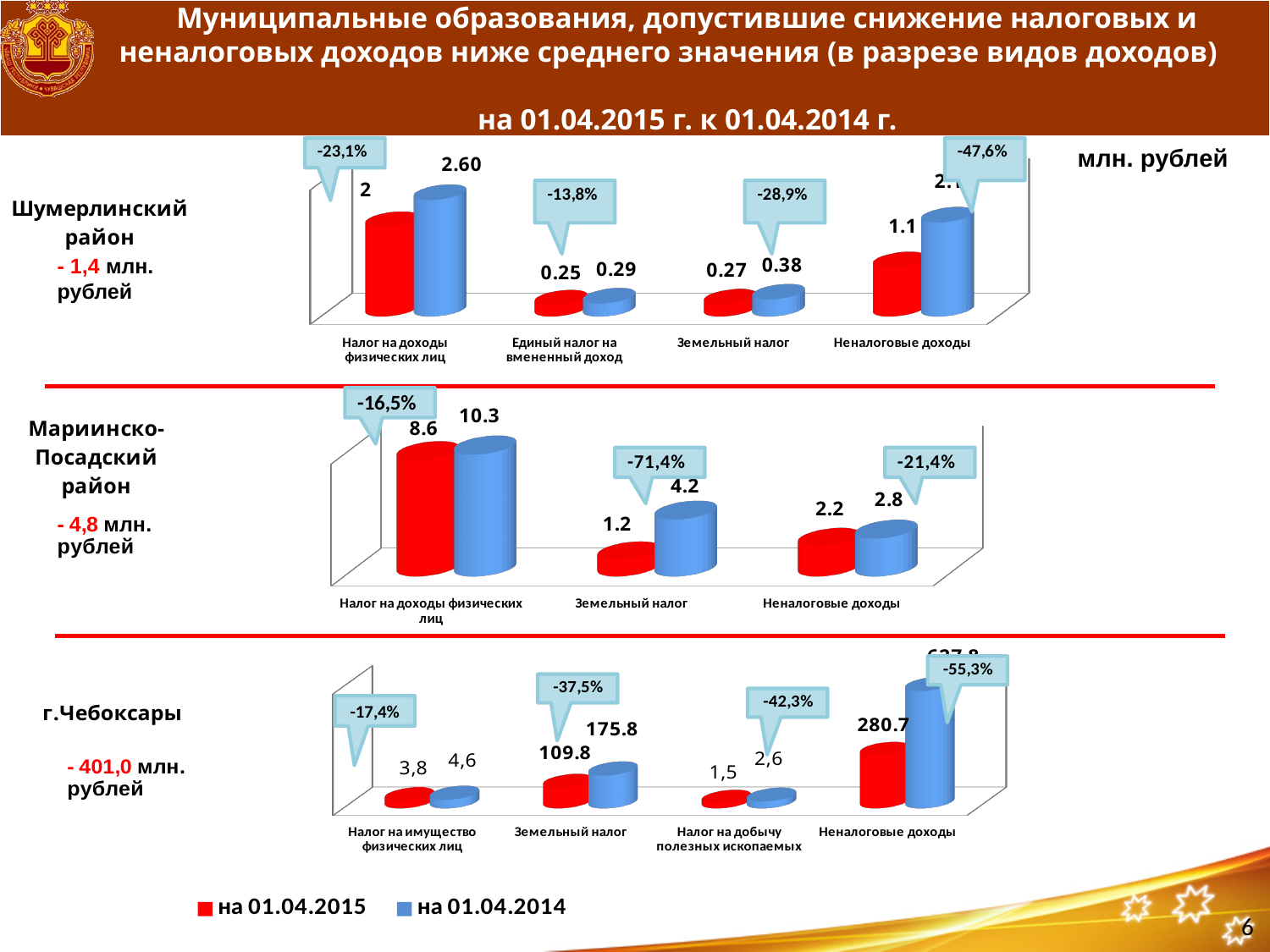
In the г.Чебоксары chart, which is larger for Налог на добычу полезных ископаемых: the на 01.04.2015 value or the на 01.04.2014 value? на 01.04.2014 In the Мариинско-Посадский район chart, what percentage change is shown in the callout above Земельный налог? -71,4% In the Шумерлинский район chart, what is the value for Налог на доходы физических лиц for на 01.04.2014? 2.60 In the Мариинско-Посадский район chart, which category has the highest value for на 01.04.2015? Налог на доходы физических лиц How many series does the legend at the bottom of the slide list? 2 In the Мариинско-Посадский район chart, what is the difference between the на 01.04.2014 and на 01.04.2015 values for Налог на доходы физических лиц? 1.7 In the г.Чебоксары chart, what is the value for Земельный налог for на 01.04.2015? 109.8 In the Шумерлинский район chart, which category has the lowest value for на 01.04.2015? Единый налог на вмененный доход In the Мариинско-Посадский район chart, what is the value for Земельный налог for на 01.04.2014? 4.2 In the г.Чебоксары chart, what is the difference between the на 01.04.2014 and на 01.04.2015 values for Земельный налог? 66.0 In the Шумерлинский район chart, what is the value for Земельный налог for на 01.04.2015? 0.27 In the Шумерлинский район chart, how many categories are shown on the x axis? 4